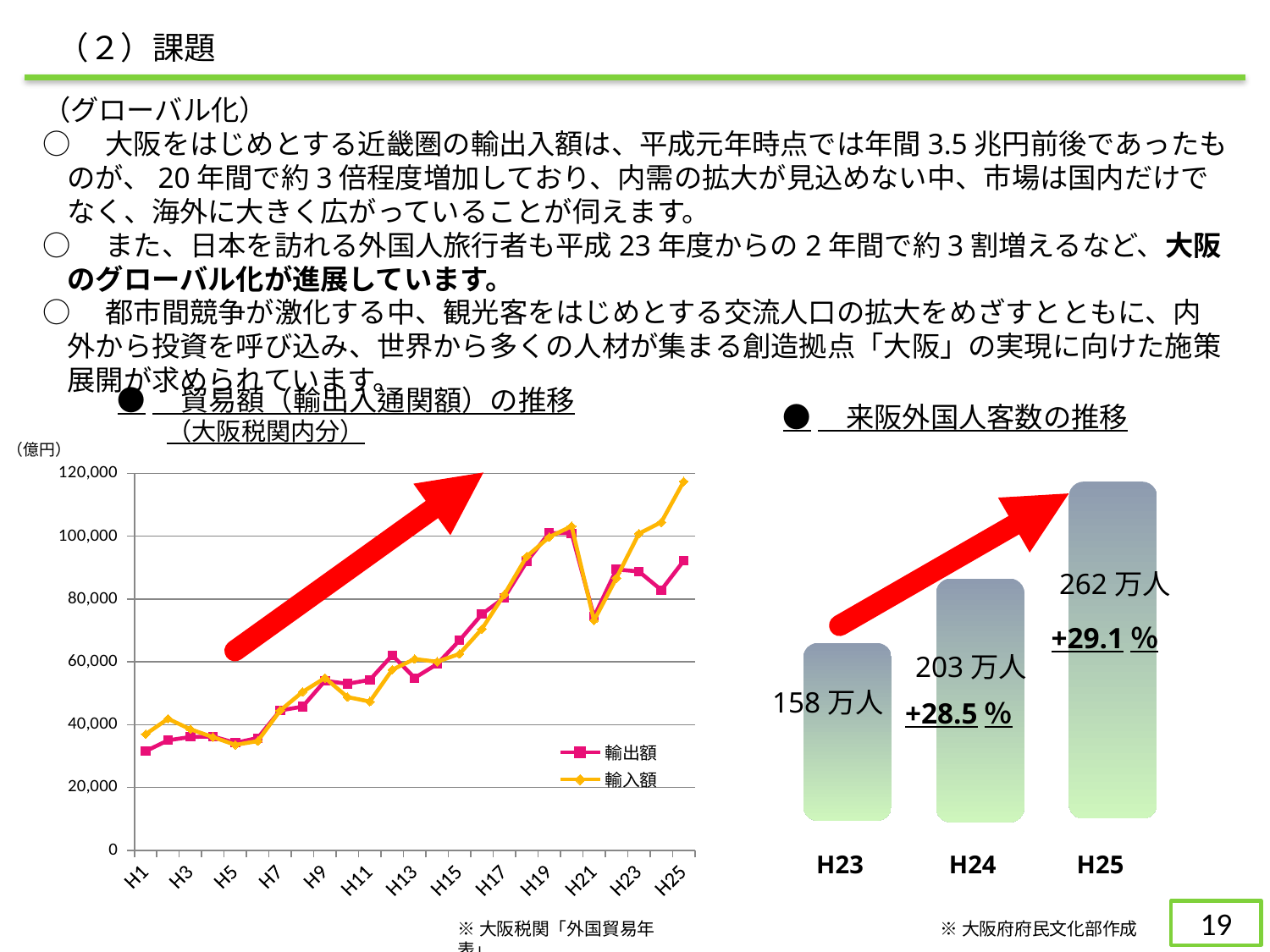
In the chart titled 貿易額（輸出入通関額）の推移, is the value of 輸出額 at H1 greater or less than 40,000? less In the chart titled 貿易額（輸出入通関額）の推移, how many series does the legend list? 2 In the chart titled 来阪外国人客数の推移, which year has the highest value? H25 In the chart titled 来阪外国人客数の推移, what is the value for H23? 158 万人 What kind of chart is the one titled 貿易額（輸出入通関額）の推移? line chart In the chart titled 来阪外国人客数の推移, what is the value for H25? 262 万人 In the chart titled 来阪外国人客数の推移, what is the difference between the H25 and H23 values? 104 万人 In the chart titled 貿易額（輸出入通関額）の推移, is the value of 輸入額 at H25 greater or less than 100,000? greater In the chart titled 来阪外国人客数の推移, how many years are shown? 3 In the chart titled 来阪外国人客数の推移, which year has the lowest value? H23 In the chart titled 貿易額（輸出入通関額）の推移, do the values generally rise or fall from H1 to H25? rise In the chart titled 来阪外国人客数の推移, what percentage increase is shown from H24 to H25? +29.1 %